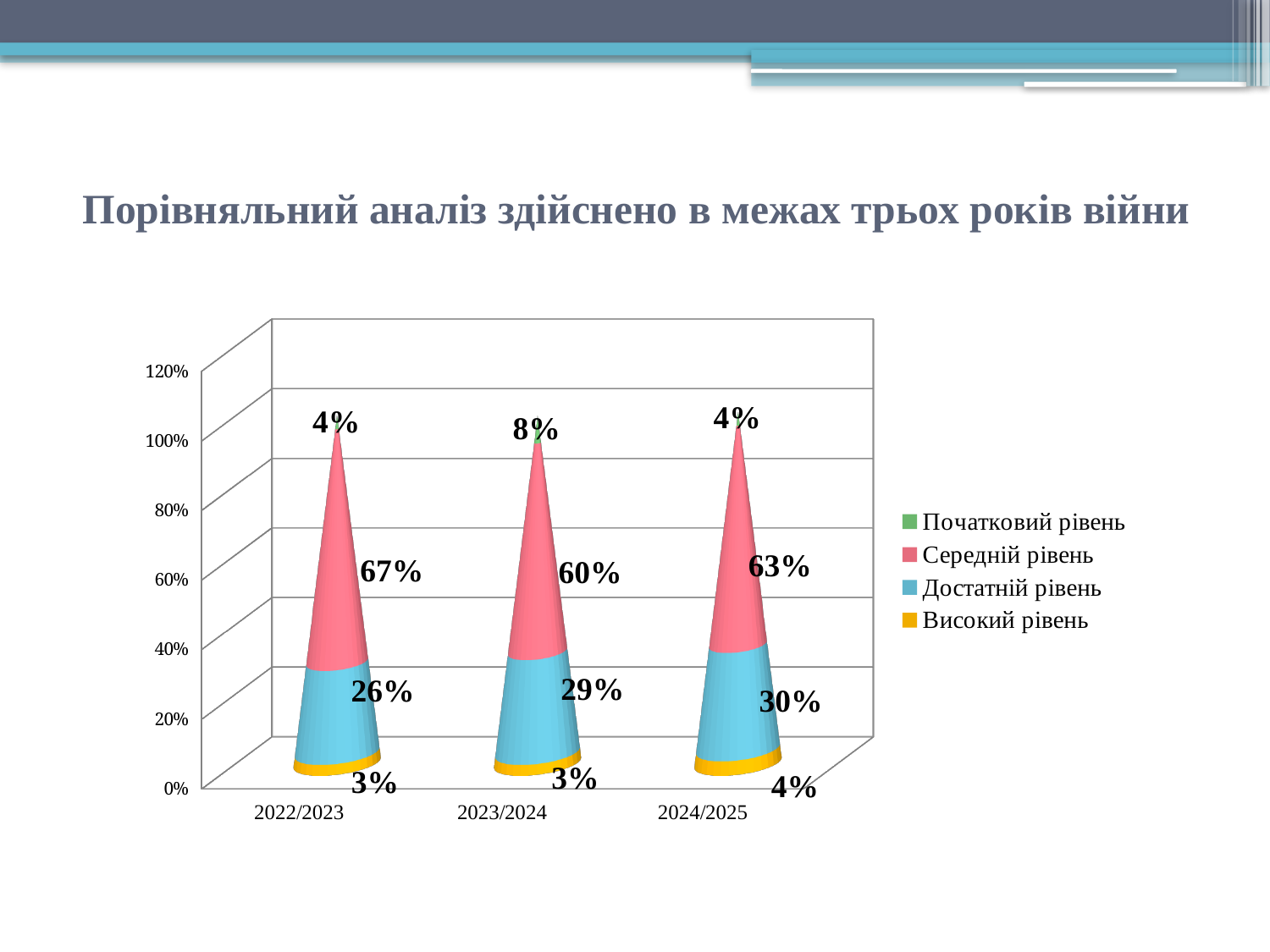
Which is larger: Початковий рівень in 2023/2024 or in 2024/2025? 2023/2024 What is the value of Достатній рівень for 2024/2025? 30% In which school year is Достатній рівень the lowest? 2022/2023 How many categories (school years) are shown on the x axis? 3 Which series is shown in yellow in the legend? Високий рівень What type of chart is shown on the slide? stacked bar chart What is the value of Початковий рівень for 2023/2024? 8% In which school year is Середній рівень the highest? 2022/2023 What is the value of Середній рівень for 2022/2023? 67% What is the value of Високий рівень for 2022/2023? 3% What is the difference between Середній рівень in 2022/2023 and in 2023/2024? 7% How many series does the legend list? 4